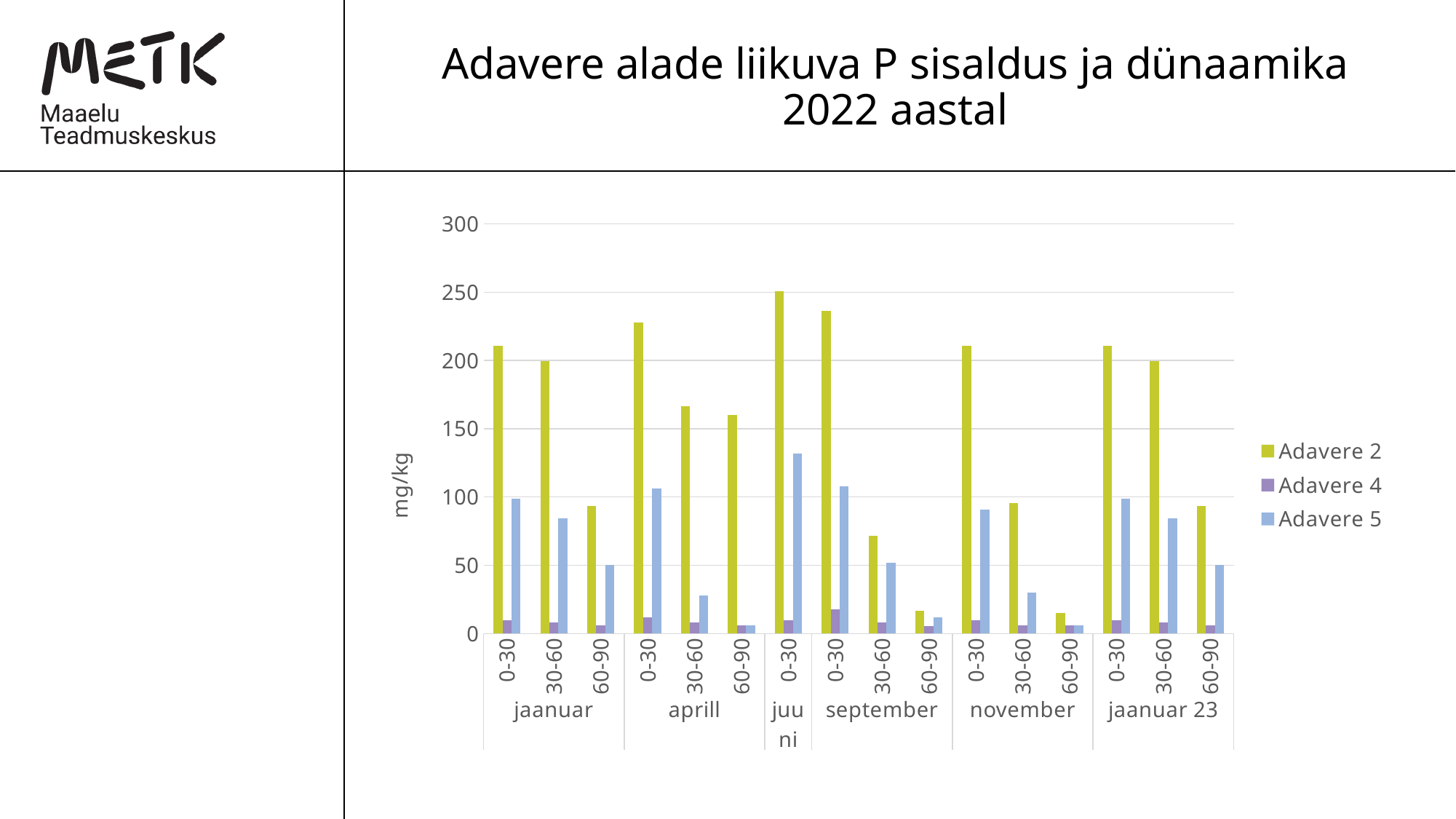
Is the value for Adavere 2 at september 60-90 greater or less than 50? less What kind of chart is shown on the slide? bar chart In which month and depth does Adavere 2 reach its highest value? juuni 0-30 Is the value for Adavere 2 at aprill 0-30 greater or less than 200? greater Is the value for Adavere 5 at juuni 0-30 greater or less than 100? greater At jaanuar 0-30, which is larger: Adavere 2 or Adavere 5? Adavere 2 What are the three series named in the legend? Adavere 2, Adavere 4, Adavere 5 How many series does the legend list? 3 What is the label on the vertical axis? mg/kg How many month groups are shown along the x axis? 6 In which month and depth does Adavere 5 reach its highest value? juuni 0-30 Within september, do the Adavere 2 values rise or fall from 0-30 to 60-90? fall